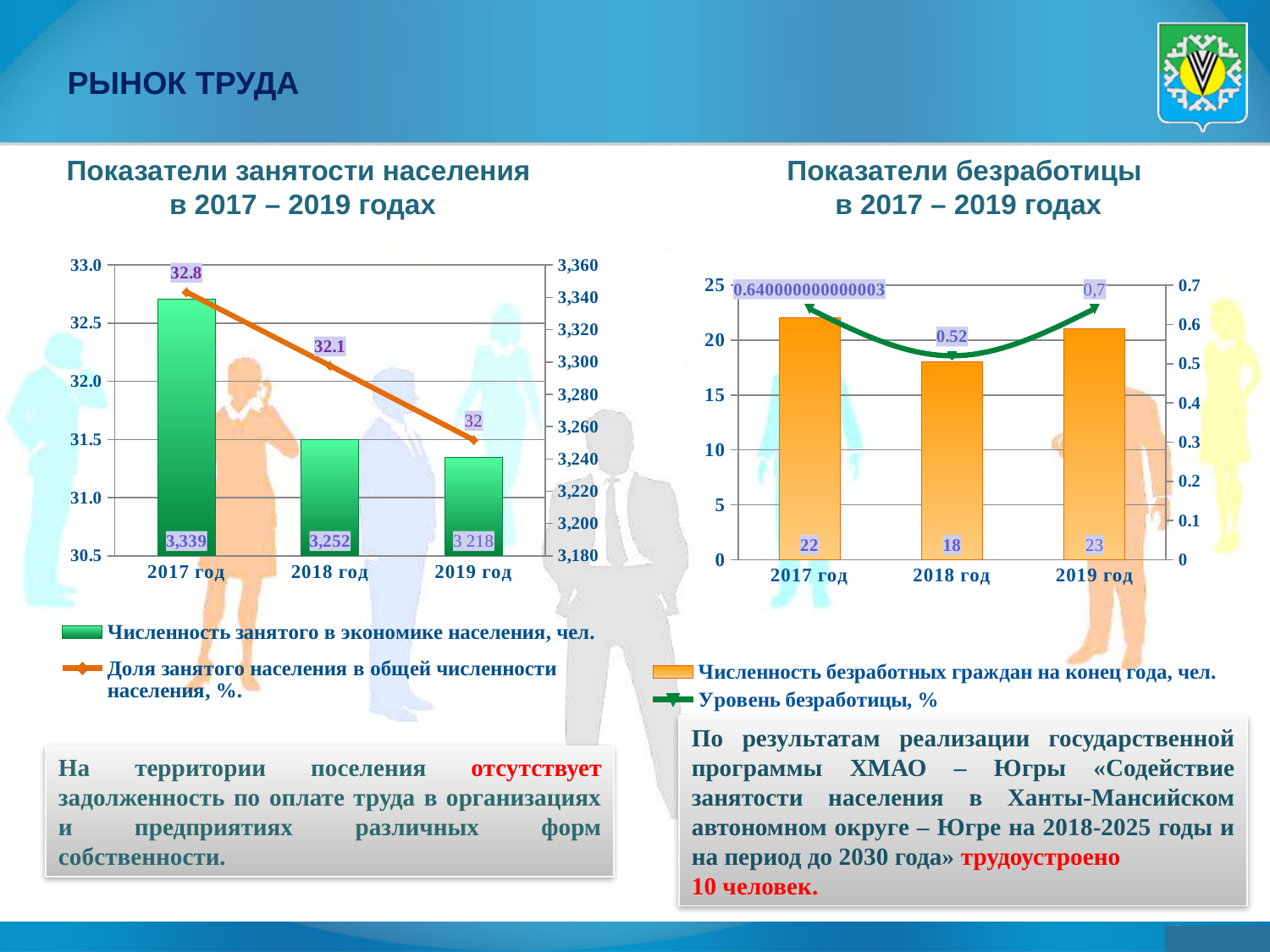
On the left chart (Показатели занятости населения), does the Доля занятого населения line rise or fall from 2017 год to 2019 год? fall On the left chart (Показатели занятости населения), which year has the lowest Численность занятого в экономике населения? 2019 год On the left chart (Показатели занятости населения), what is the value of Численность занятого в экономике населения for 2017 год? 3,339 On the left chart (Показатели занятости населения), what is the difference in Численность занятого в экономике населения between 2017 год and 2018 год? 87 On the right chart (Показатели безработицы), what is the Численность безработных граждан на конец года for 2018 год? 18 On the right chart (Показатели безработицы), what is the Уровень безработицы for 2018 год? 0.52 On the right chart (Показатели безработицы), which year has the larger Численность безработных граждан, 2017 год or 2018 год? 2017 год On the left chart (Показатели занятости населения), what is the value of Доля занятого населения в общей численности населения for 2018 год? 32.1 On the right chart (Показатели безработицы), how many years are shown on the x axis? 3 On the left chart (Показатели занятости населения), how many series does the legend list? 2